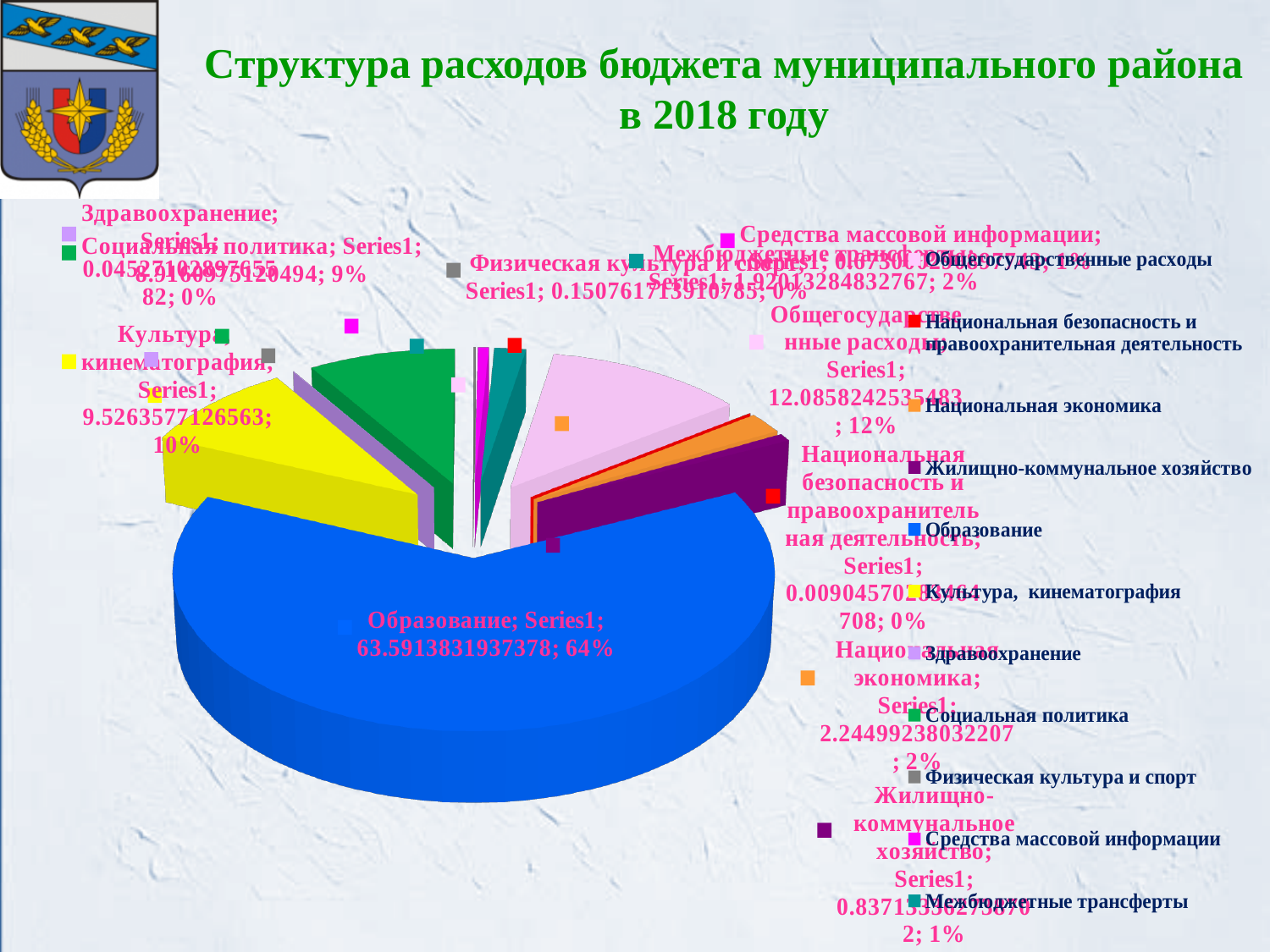
What is the title of the chart on the slide? Структура расходов бюджета муниципального района в 2018 году What percentage share does Образование have? 64% What percentage share does Культура, кинематография have? 10% What percentage share does Межбюджетные трансферты have? 2% Which is larger: the share for Культура, кинематография or the share for Общегосударственные расходы? Общегосударственные расходы What is the difference in percentage points between the share for Образование and the share for Общегосударственные расходы? 52% Which category has the largest share of the pie? Образование What kind of chart is shown on the slide? pie chart How many categories does the legend list? 11